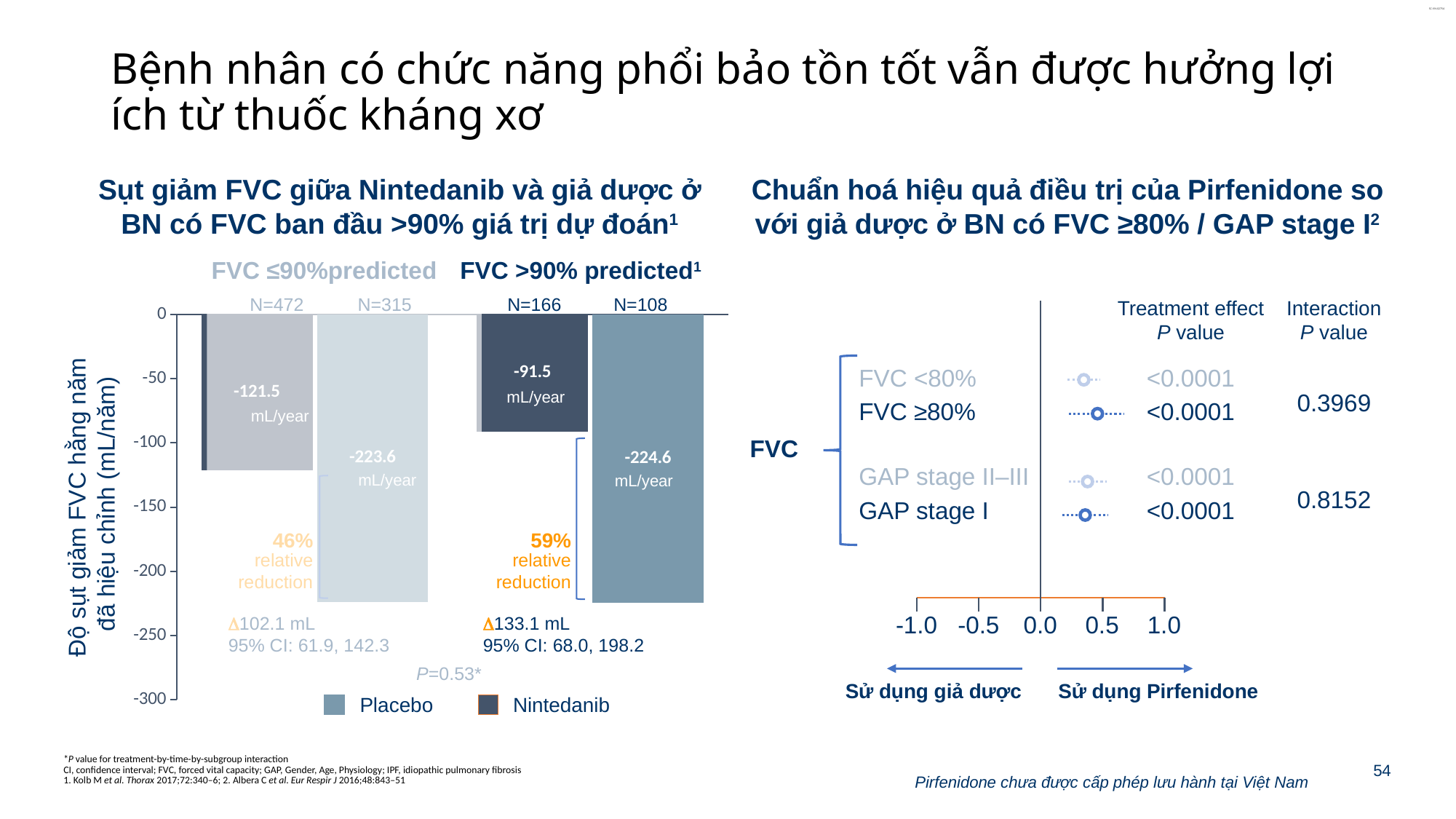
In the right chart (Pirfenidone), what is the interaction P value for the FVC <80% vs FVC ≥80% subgroups? 0.3969 In the left bar chart, how many patients (N) are in the Nintedanib arm of the FVC >90% predicted group? N=166 In the left bar chart, what is the P value for the treatment-by-time-by-subgroup interaction? P=0.53 In the left bar chart, which arm shows the larger annual FVC decline in the FVC ≤90% predicted group, Placebo or Nintedanib? Placebo In the left bar chart, what is the annual FVC decline for Placebo in the FVC ≤90% predicted group? -223.6 mL/year In the left bar chart, what is the annual FVC decline for Nintedanib in the FVC >90% predicted group? -91.5 mL/year In the right chart (Pirfenidone), what is the interaction P value for the GAP stage subgroups? 0.8152 In the left bar chart, what is the difference between the Placebo and Nintedanib annual FVC decline in the FVC >90% predicted group? 133.1 mL What kind of chart is the left chart on the slide? Bar chart In the left bar chart, which bar shows the smallest annual FVC decline? Nintedanib, FVC >90% predicted (-91.5 mL/year) How many series does the legend of the left bar chart list? 2 In the left bar chart, what relative reduction is shown for the FVC >90% predicted group? 59%